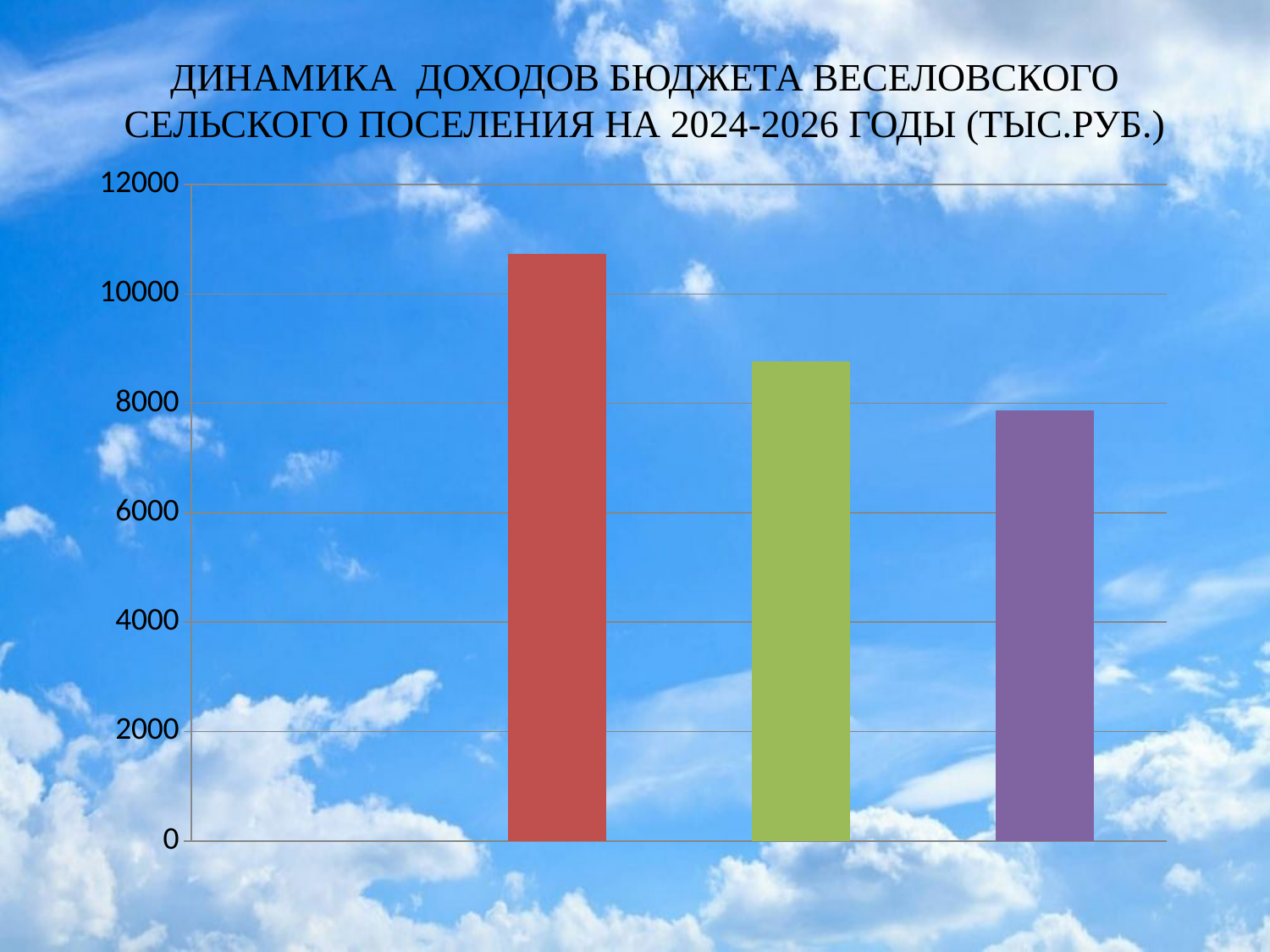
Is the value of the green (second) bar greater or less than 8000? greater Do the bar values rise or fall from left to right across the chart? fall What is the highest value shown on the vertical axis of the chart? 12000 How many bars are plotted in the chart? 3 Which bar is the tallest in the chart: the red, green or purple one? red What kind of chart is shown on the slide? bar chart Is the value of the green (second) bar greater or less than 10000? less According to the chart title, which years does the chart cover? 2024-2026 Which is larger, the red bar or the green bar? red bar Which bar is the shortest in the chart: the red, green or purple one? purple Is the value of the red (first) bar greater or less than 10000? greater